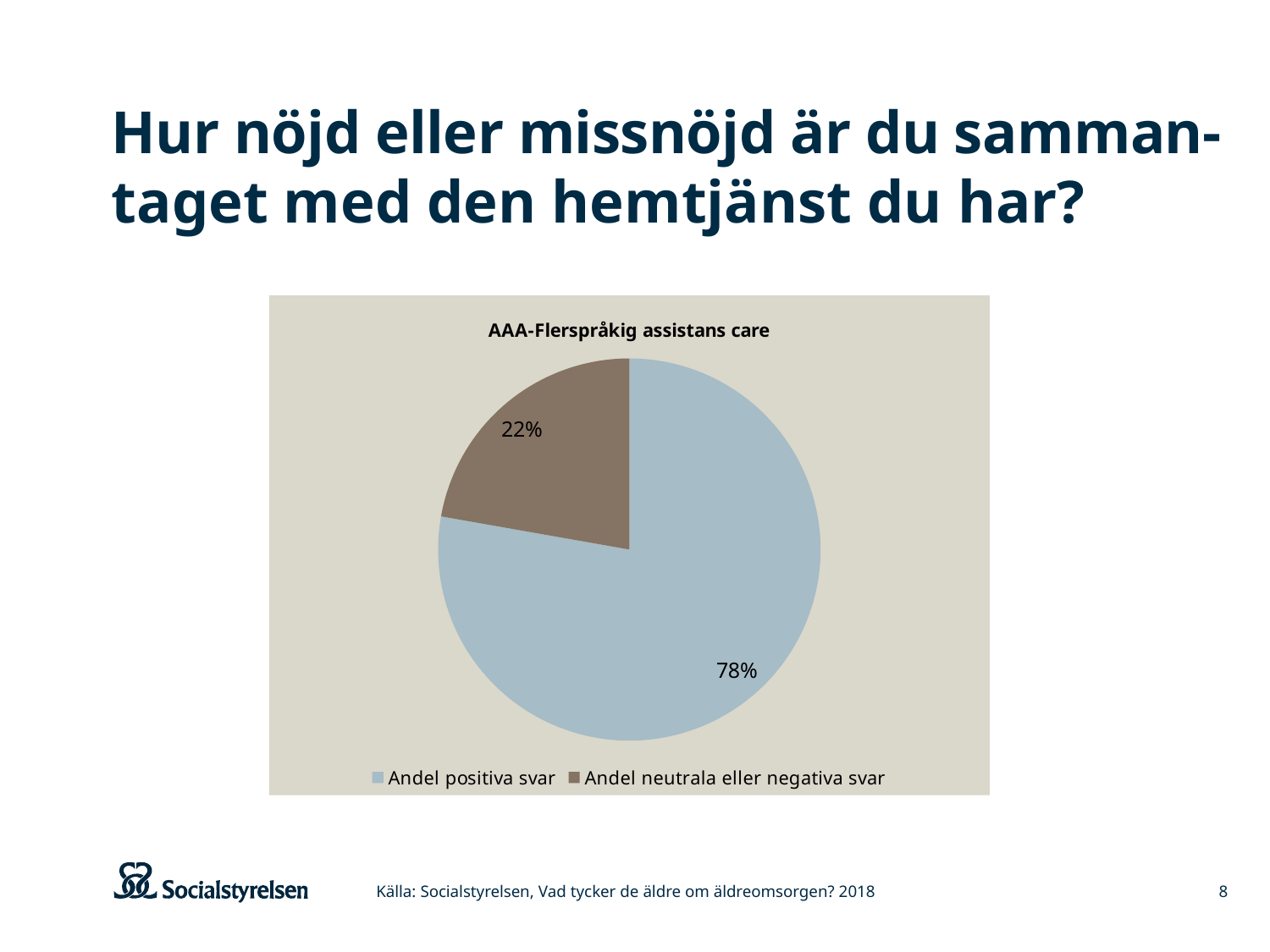
What is the value for Andel neutrala eller negativa svar? 22% What is the difference between Andel positiva svar and Andel neutrala eller negativa svar? 56% Which slice is the smallest? Andel neutrala eller negativa svar Which is larger, Andel positiva svar or Andel neutrala eller negativa svar? Andel positiva svar What share of the pie does Andel neutrala eller negativa svar represent? 22% What colour is the Andel positiva svar slice? light blue What is the title of the chart? AAA-Flerspråkig assistans care Which slice is the largest? Andel positiva svar How many slices does the pie chart have? 2 What type of chart is shown on the slide? pie chart How many entries does the legend list? 2 What is the value for Andel positiva svar? 78%